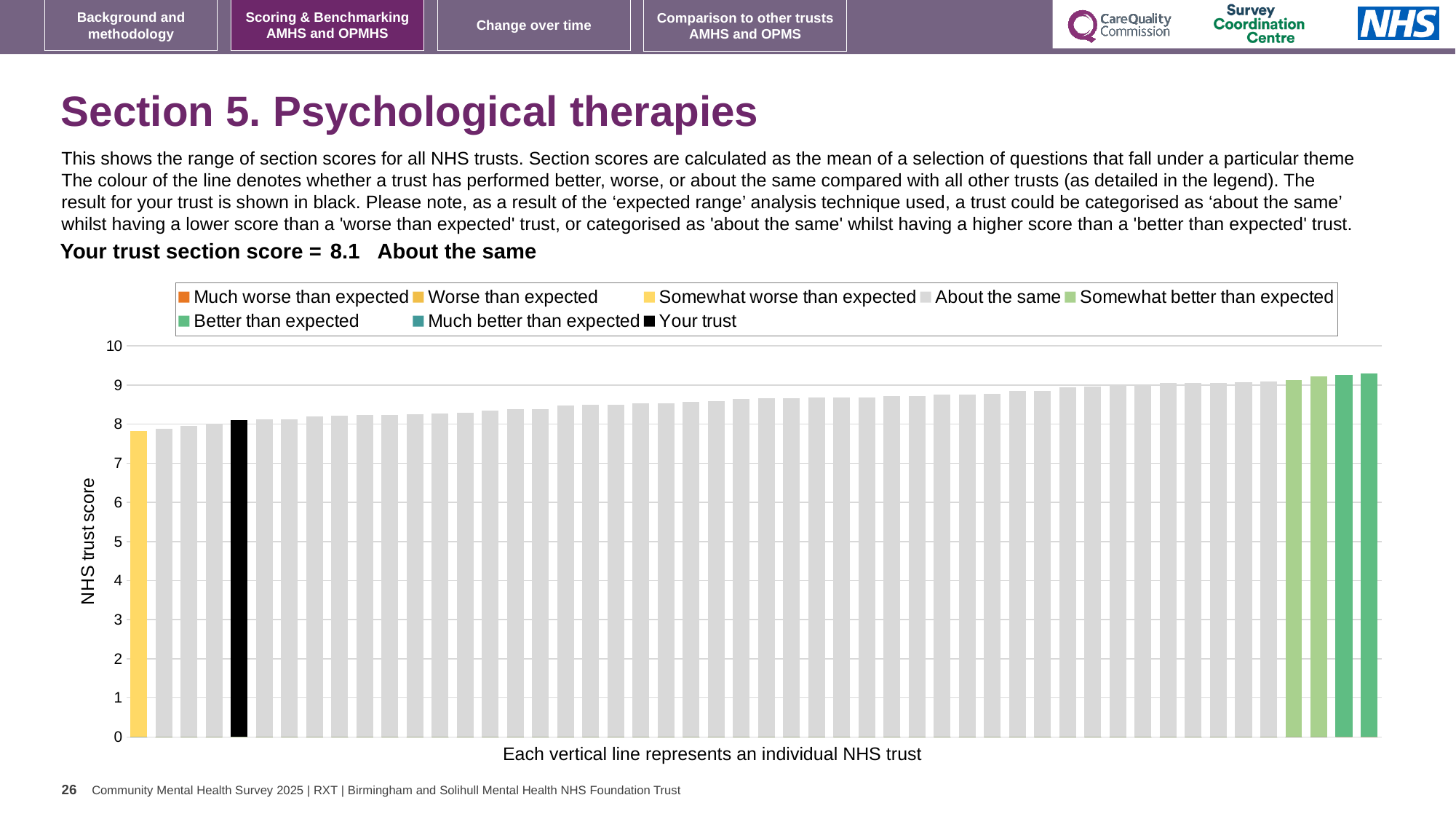
Is the value of the tallest bar greater or less than 9? greater Which legend category does the tallest bar belong to? Better than expected What kind of chart is shown on the slide? Bar chart Which legend category does the shortest bar belong to? Somewhat worse than expected Which category is your trust placed in for this section? About the same Is the value of the leftmost (yellow) bar greater or less than 8? less What is the label on the vertical axis of the chart? NHS trust score How many bars are coloured as 'Somewhat worse than expected'? 1 Which is taller: the black 'Your trust' bar or the yellow 'Somewhat worse than expected' bar? The black 'Your trust' bar How many entries does the chart legend list? 8 Do the bar values rise or fall from left to right along the x axis? Rise What is the section score for your trust shown on the slide? 8.1